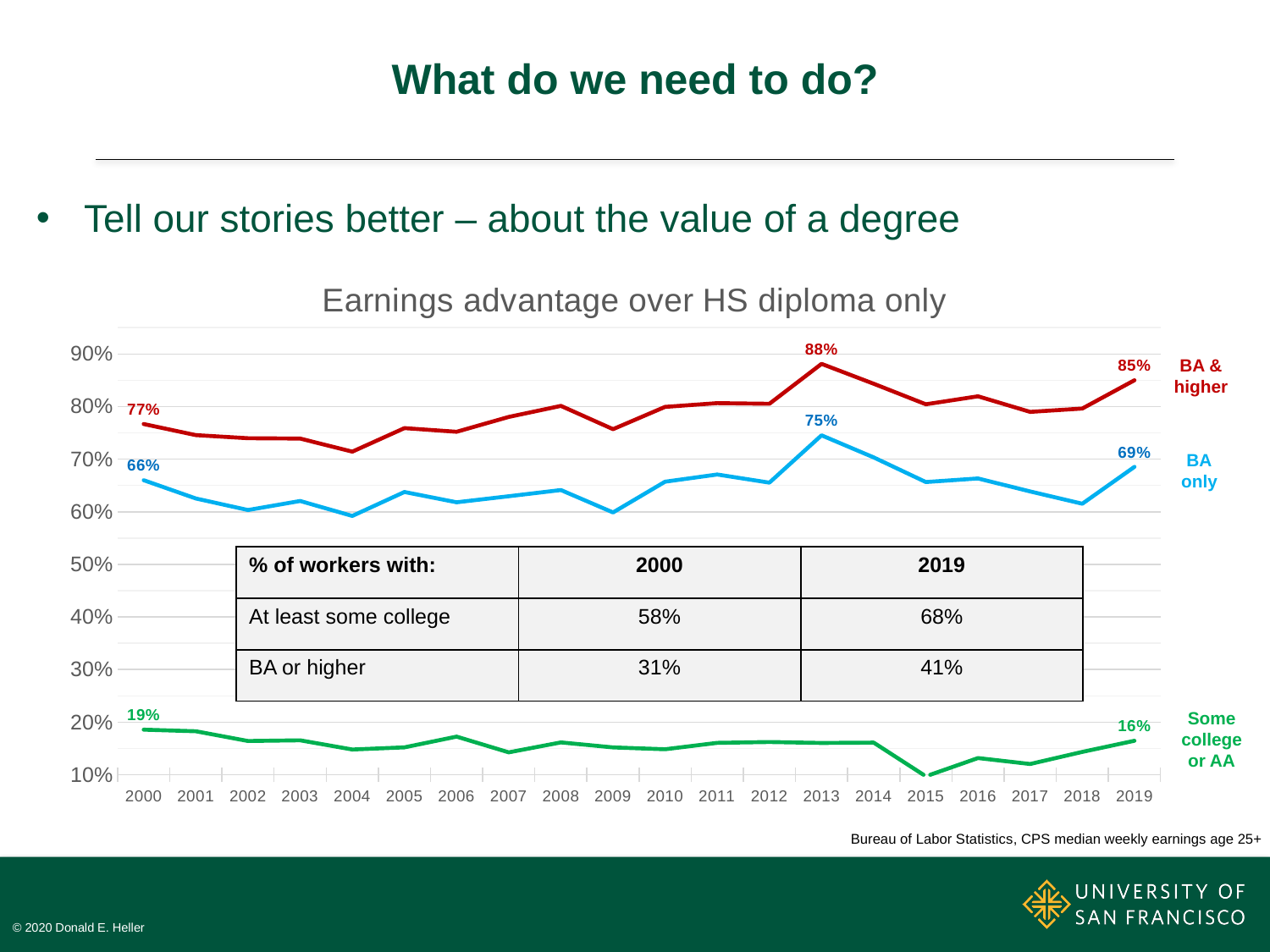
What is the difference between BA & higher and BA only in 2013? 13% Which series has the highest earnings advantage in 2019? BA & higher How many years are shown on the x axis? 20 Is the value for Some college or AA in 2015 greater or less than 20%? less Which series has the lowest earnings advantage in 2000? Some college or AA What kind of chart is shown? line chart What is the value for Some college or AA in 2000? 19% Which is larger in 2019, the value for BA & higher or the value for BA only? BA & higher What is the value for BA only in 2019? 69% What is the value for BA & higher in 2000? 77% What is the value for BA & higher in 2013? 88% What is the title of the chart? Earnings advantage over HS diploma only